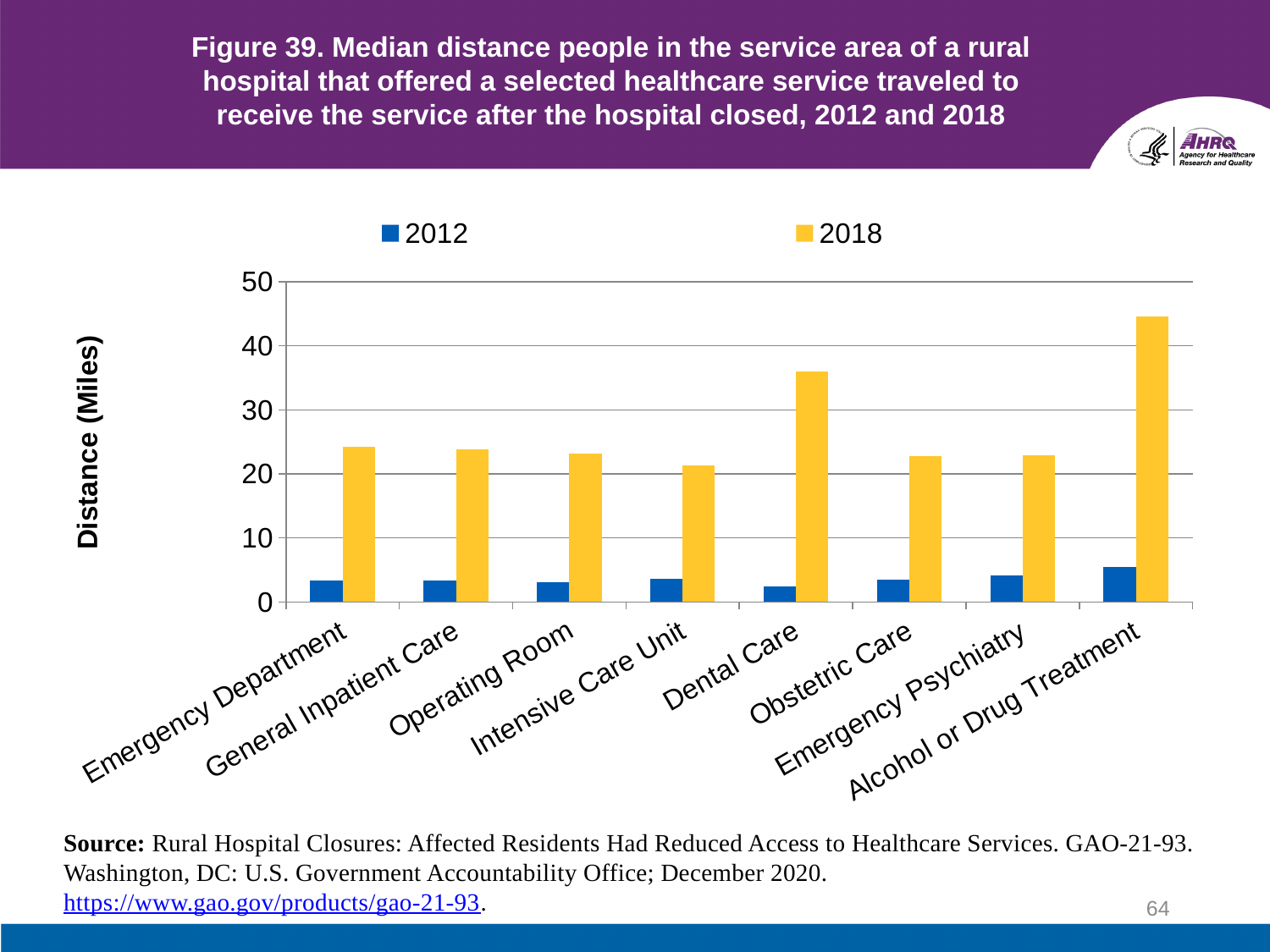
Which healthcare service has the highest 2012 median distance? Alcohol or Drug Treatment Is the 2018 value for Intensive Care Unit greater or less than 30? less How many series does the legend list? 2 Which is larger, the 2018 value for Alcohol or Drug Treatment or the 2018 value for Dental Care? Alcohol or Drug Treatment What is the title of the y axis? Distance (Miles) Which healthcare service has the highest 2018 median distance? Alcohol or Drug Treatment Is the 2018 value for Alcohol or Drug Treatment greater or less than 40? greater What kind of chart is shown on the slide? bar chart How many healthcare service categories are shown on the x axis? 8 Which is larger, the 2018 value for Dental Care or the 2018 value for Emergency Department? Dental Care Is the 2018 value for Dental Care greater or less than 30? greater